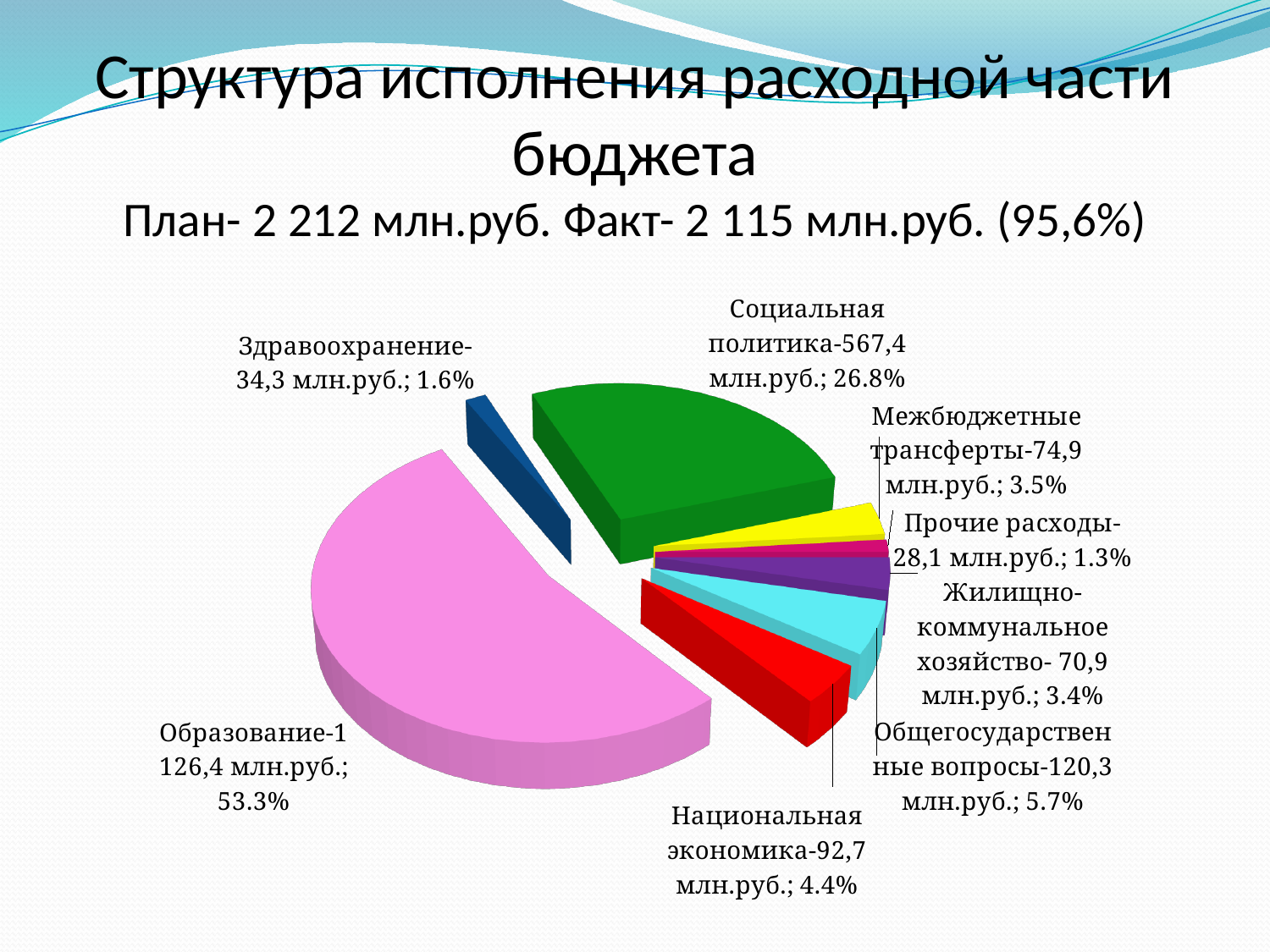
Which is larger, Межбюджетные трансферты or Жилищно-коммунальное хозяйство? Межбюджетные трансферты What is the value shown for Общегосударственные вопросы? 120,3 млн.руб. How many slices does the pie chart have? 8 What percentage is shown for Жилищно-коммунальное хозяйство? 3.4% What share of the pie does Образование account for? 53.3% Which category has the smallest slice of the pie? Прочие расходы What is the difference in percentage points between Общегосударственные вопросы (5.7%) and Национальная экономика (4.4%)? 1.3 What colour is the Образование slice? pink What kind of chart is shown on the slide? pie chart Which category has the largest slice of the pie? Образование What is the value shown for Социальная политика? 567,4 млн.руб. What percentage is shown for Здравоохранение? 1.6%